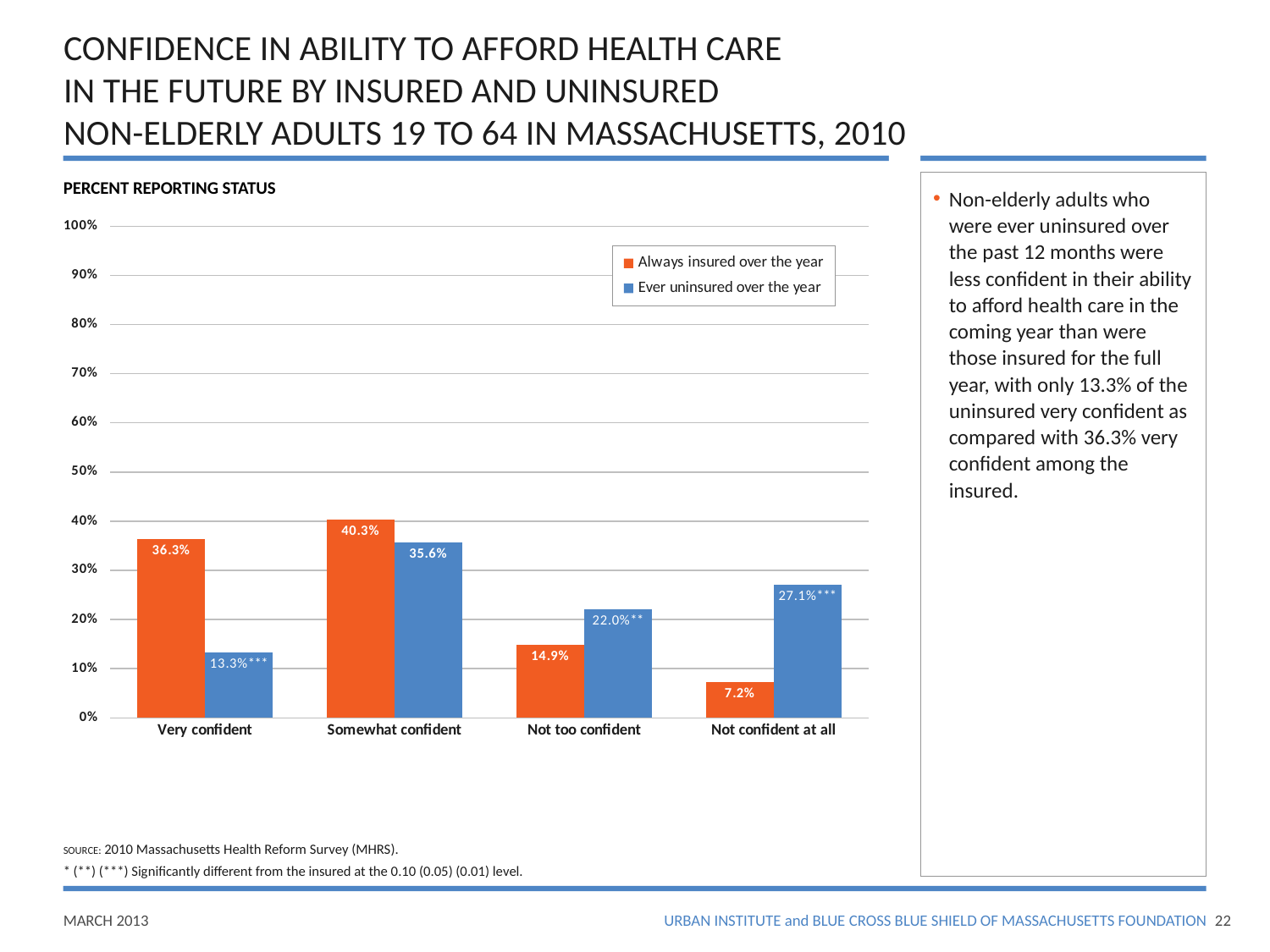
How many confidence categories are shown on the x axis? 4 How many series does the legend list? 2 What percentage of adults always insured over the year were very confident? 36.3% For the not too confident category, which group has the larger value: always insured or ever uninsured? Ever uninsured over the year Which colour represents adults ever uninsured over the year? Blue What is the difference between the always insured and ever uninsured values for the very confident category? 23.0% What kind of chart is shown on the slide? Bar chart Which confidence category has the lowest value for adults ever uninsured over the year? Very confident What percentage of adults ever uninsured over the year were somewhat confident? 35.6% What percentage of adults ever uninsured over the year were not confident at all? 27.1% Which confidence category has the highest value for adults always insured over the year? Somewhat confident Is the value for adults always insured who were not confident at all greater or less than 10%? less